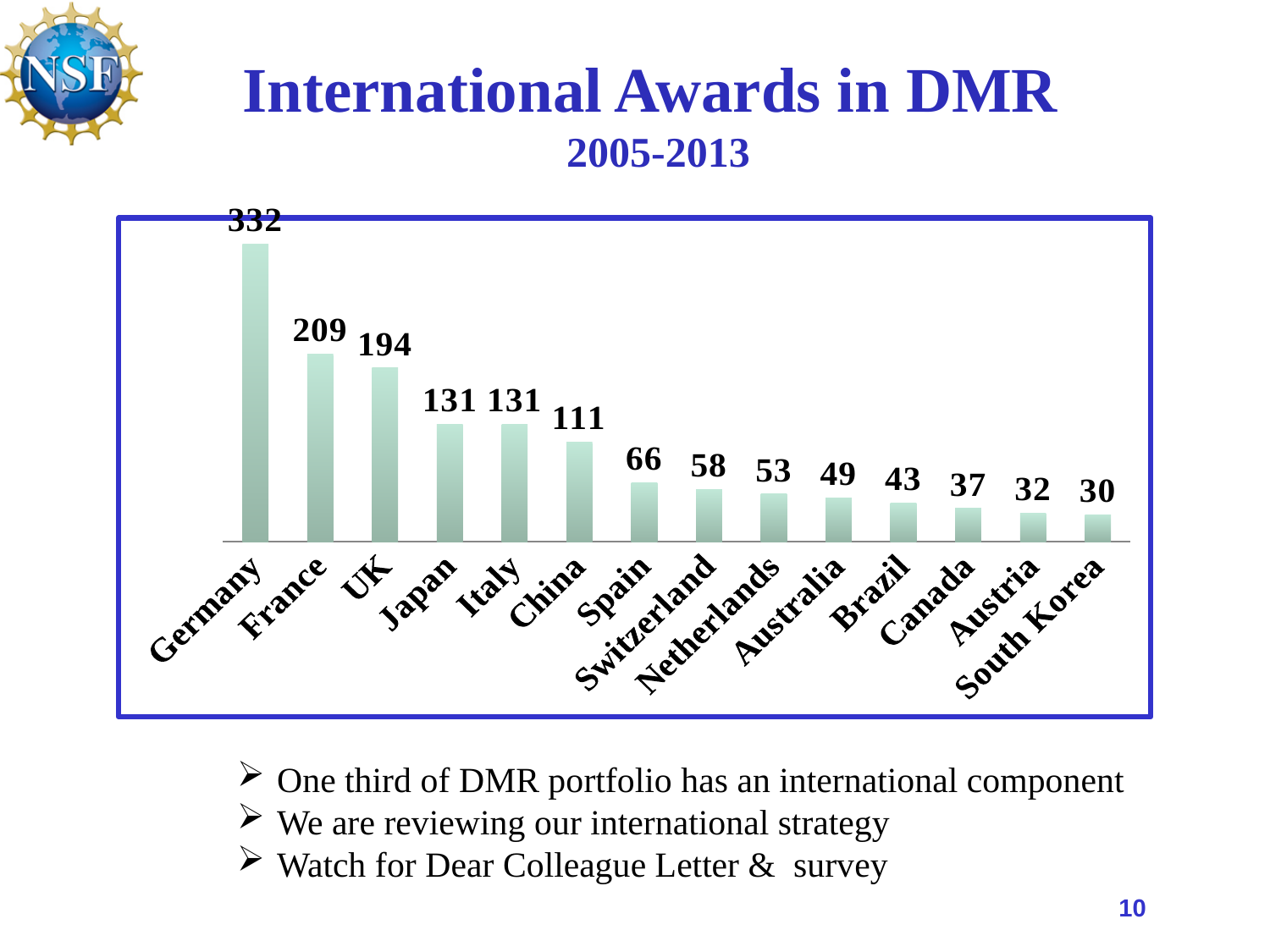
What is the value for Switzerland? 58 Which country has the lowest value? South Korea What is the value for Germany? 332 What is the value for Brazil? 43 Which country has the highest value? Germany How many countries are shown in the chart? 14 Which has a larger value, China or Spain? China What is the difference between the values for Germany and Japan? 201 What kind of chart is shown on the slide? Bar chart What is the difference between the values for France and the UK? 15 Which has a larger value, Netherlands or Canada? Netherlands Do the values rise or fall from left to right along the x axis? Fall